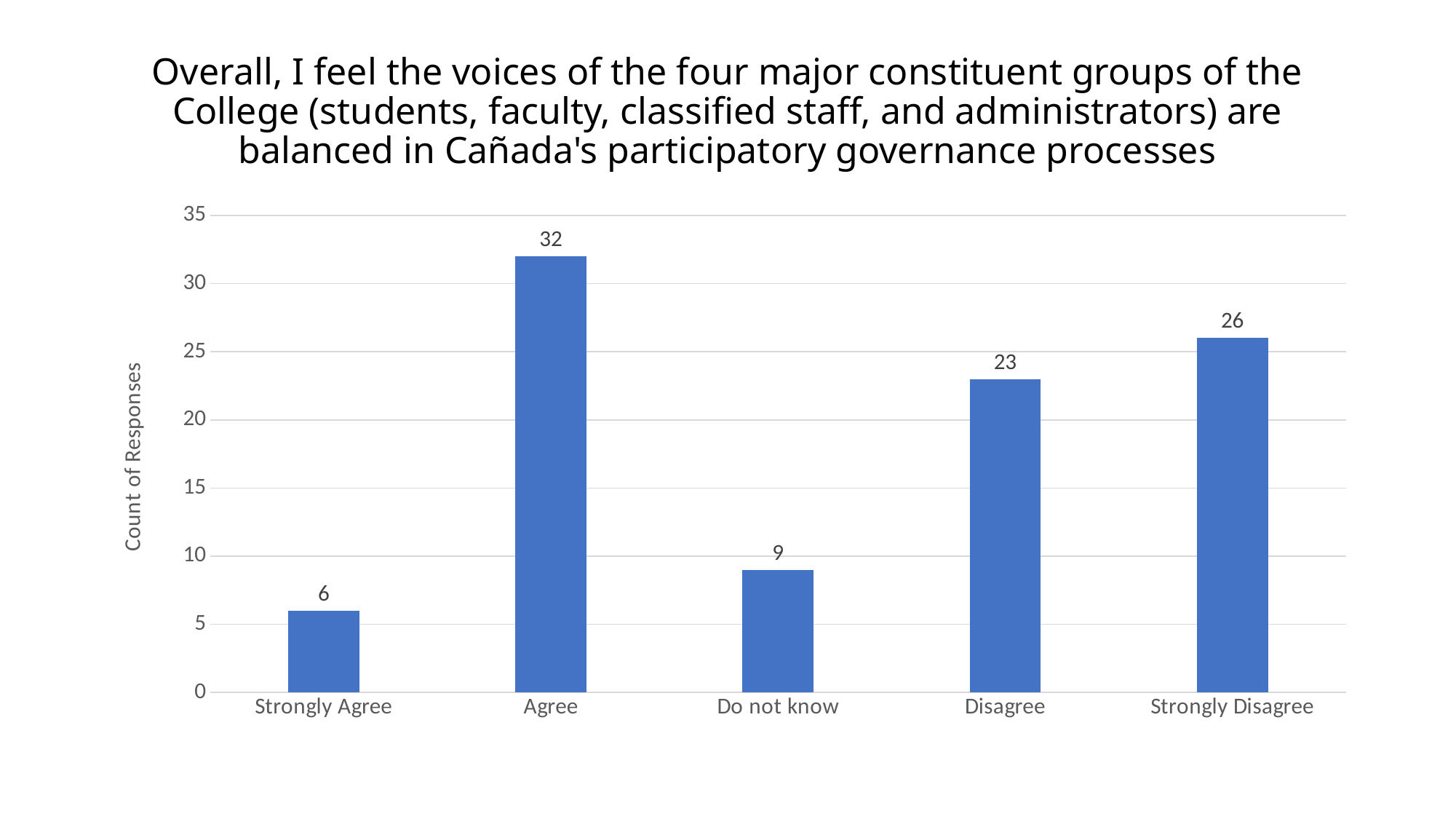
What is the count of responses for Strongly Disagree? 26 What is the difference between the counts for Strongly Disagree and Strongly Agree? 20 Which response category has the highest count? Agree What is the difference between the counts for Agree and Disagree? 9 How many responses are shown for Agree? 32 Is the value for Disagree greater or less than 20? greater What is the label of the vertical axis? Count of Responses Which response category has the lowest count? Strongly Agree What kind of chart is shown on the slide? Bar chart What is the count of responses for Do not know? 9 How many response categories are shown on the x axis? 5 Which has a higher count, Disagree or Strongly Disagree? Strongly Disagree